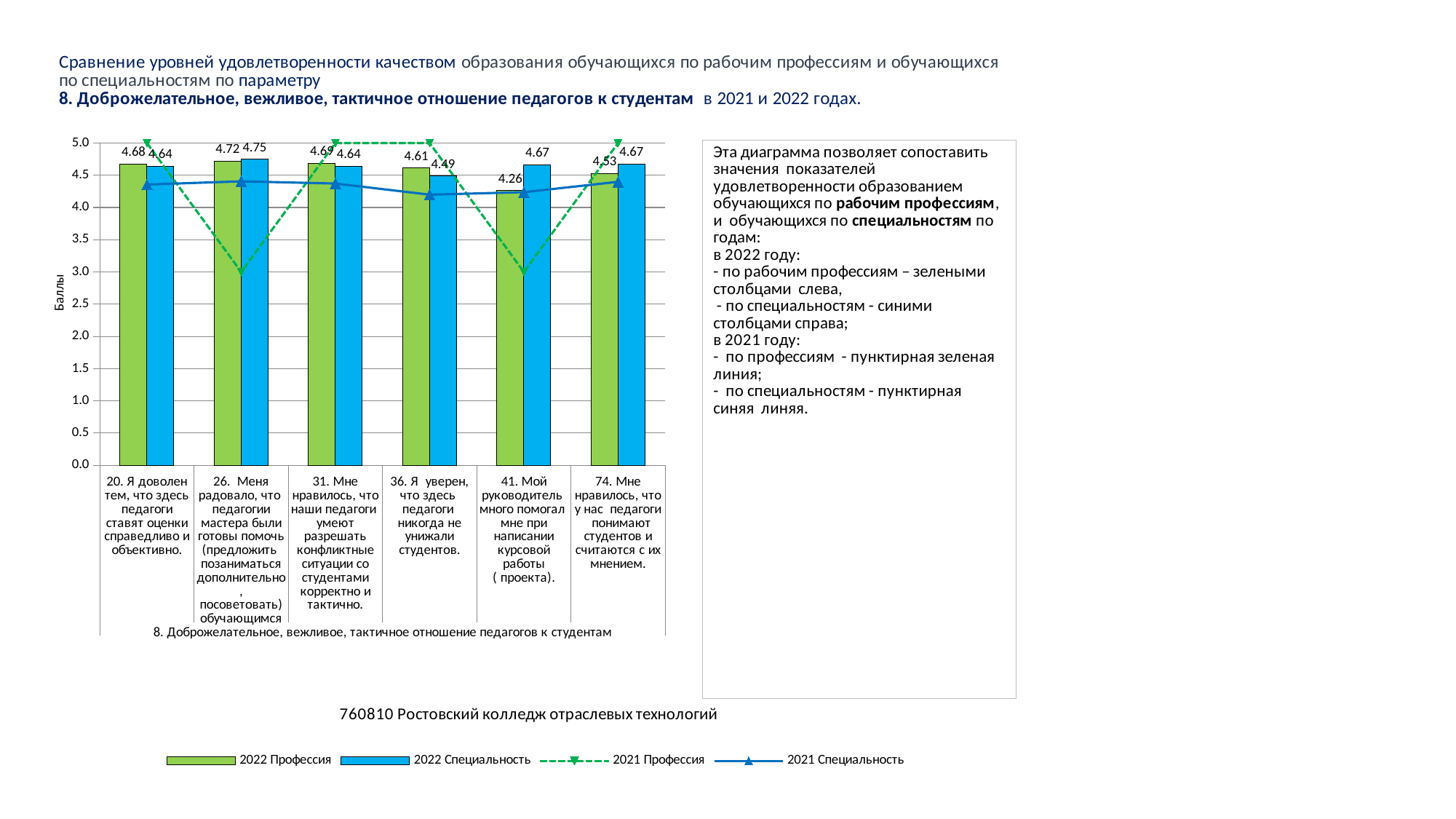
What is the value of the 2022 Профессия bar for question 20 (Я доволен тем, что здесь педагоги ставят оценки справедливо и объективно)? 4.68 What is the value of the 2022 Специальность bar for question 41 (Мой руководитель много помогал мне при написании курсовой работы)? 4.67 What is the value of the 2022 Специальность bar for question 26 (Меня радовало, что педагоги мастера были готовы помочь)? 4.75 Which category has the lowest 2022 Профессия value? 41. Мой руководитель много помогал мне при написании курсовой работы (4.26) Which category has the lowest 2022 Специальность value? 36. Я уверен, что здесь педагоги никогда не унижали студентов (4.49) What is the title of the vertical axis of the chart? Баллы How many categories (questions) are shown on the x axis of the chart? 6 Which category has the highest 2022 Профессия value? 26. Меня радовало, что педагоги мастера были готовы помочь (4.72) What is the difference between the 2022 Специальность and 2022 Профессия values for question 41? 0.41 For question 36, which is larger: the 2022 Профессия value or the 2022 Специальность value? 2022 Профессия (4.61) How many series does the chart legend list? 4 Is the 2021 Профессия line value for question 26 greater or less than 3.5? less